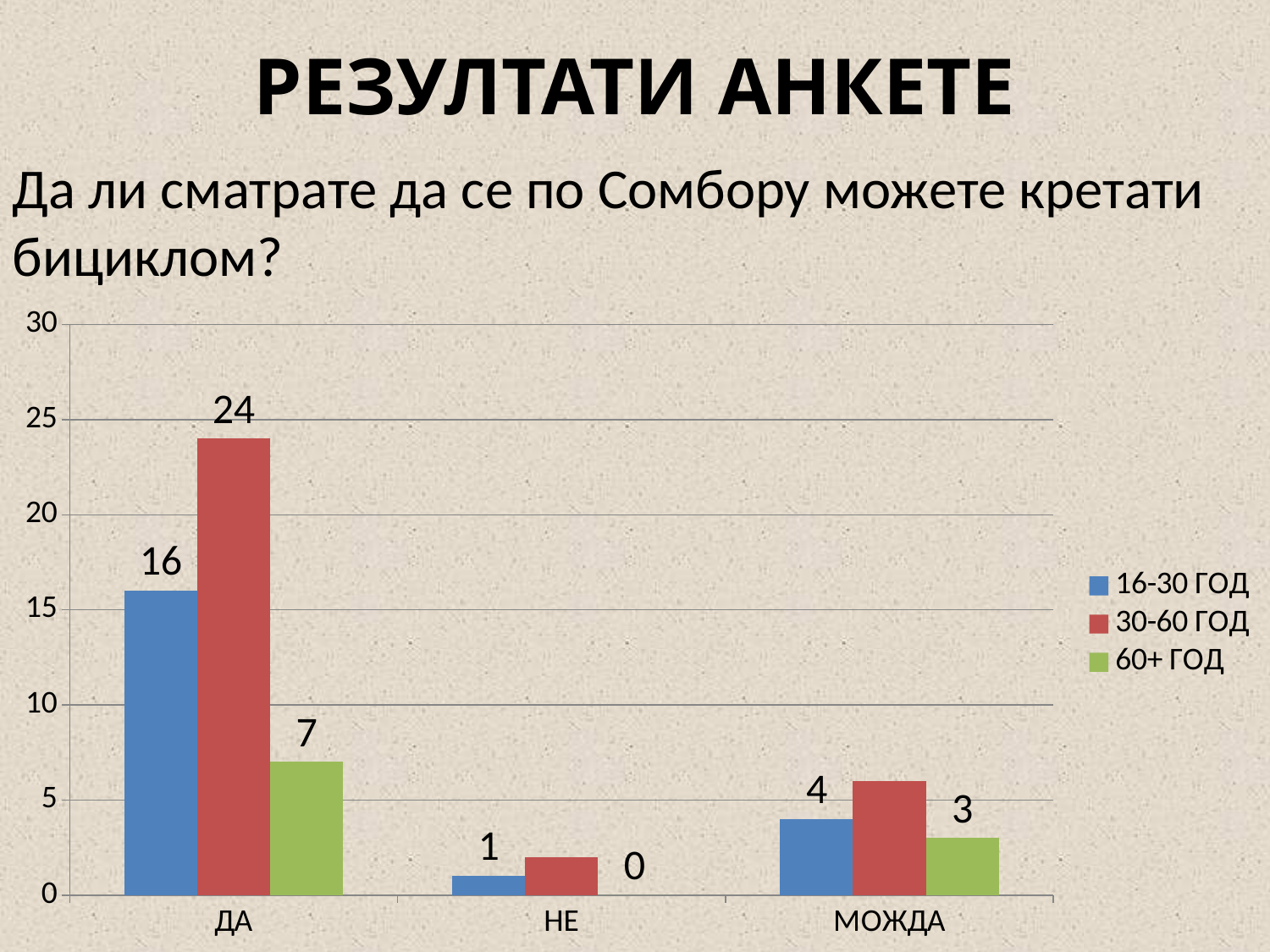
What is the difference between the 30-60 ГОД and 16-30 ГОД values in the ДА category? 8 What is the value for the 16-30 ГОД series in the МОЖДА category? 4 What is the value for the 60+ ГОД series in the ДА category? 7 Which category has the highest value for the 30-60 ГОД series? ДА How many series does the legend list? 3 What is the value for the 16-30 ГОД series in the ДА category? 16 What is the value for the 30-60 ГОД series in the ДА category? 24 Is the value for the 30-60 ГОД series in the МОЖДА category greater or less than 5? greater In the ДА category, which series has the larger value: 16-30 ГОД or 60+ ГОД? 16-30 ГОД What kind of chart is shown on the slide? bar chart Which category has the lowest value for the 60+ ГОД series? НЕ What is the value for the 60+ ГОД series in the НЕ category? 0